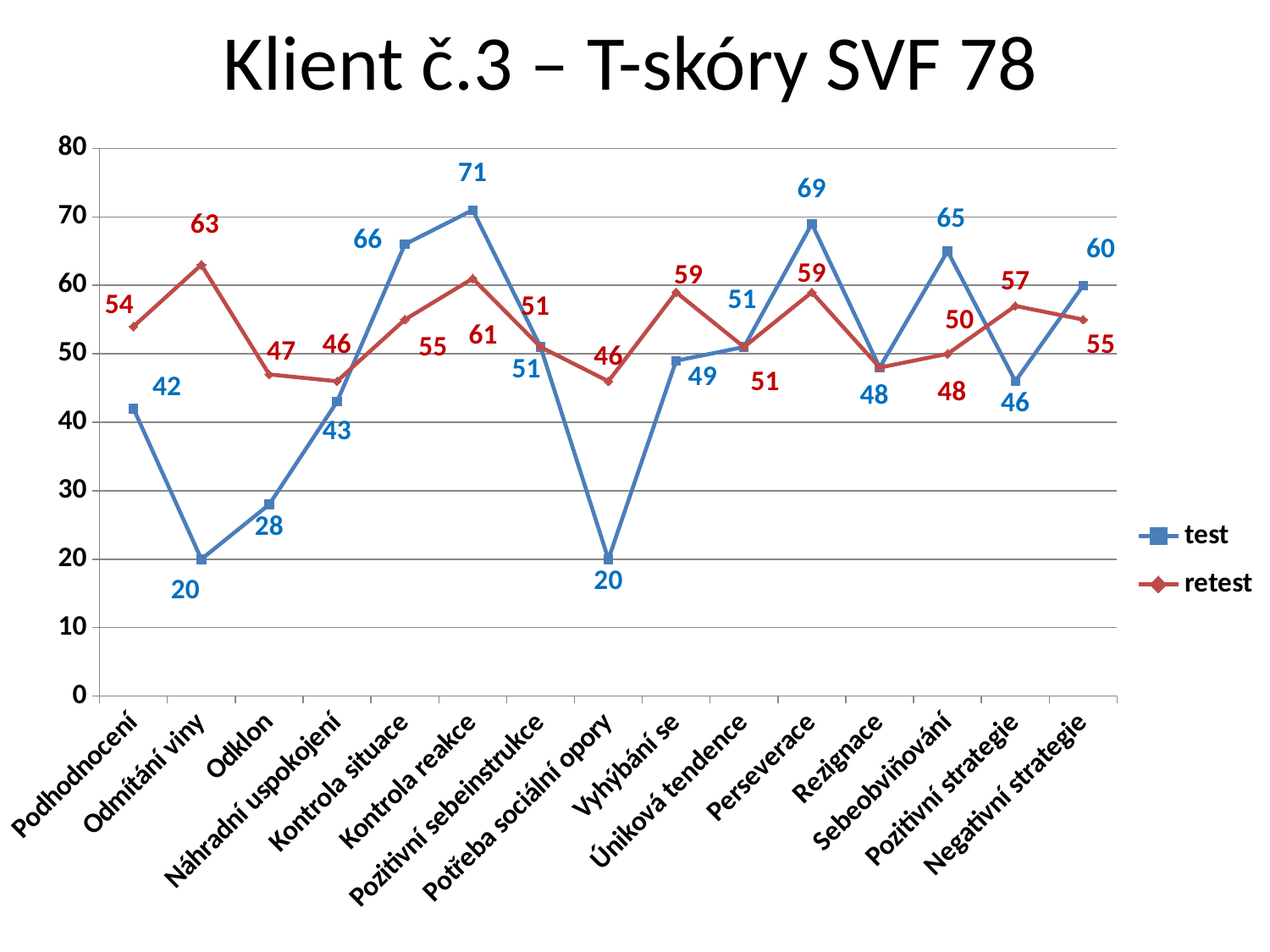
Which category has the highest test value? Kontrola reakce What is the test value for Sebeobviňování? 65 Which category has the highest retest value? Odmítání viny What is the test value for Kontrola reakce? 71 What is the difference between the retest and test values for Odmítání viny? 43 For Podhodnocení, which is larger, the test value or the retest value? retest What is the retest value for Pozitivní strategie? 57 What is the difference between the test and retest values for Perseverace? 10 How many categories are shown on the x axis? 15 What is the retest value for Odmítání viny? 63 How many series does the legend list? 2 What kind of chart is shown on the slide? line chart